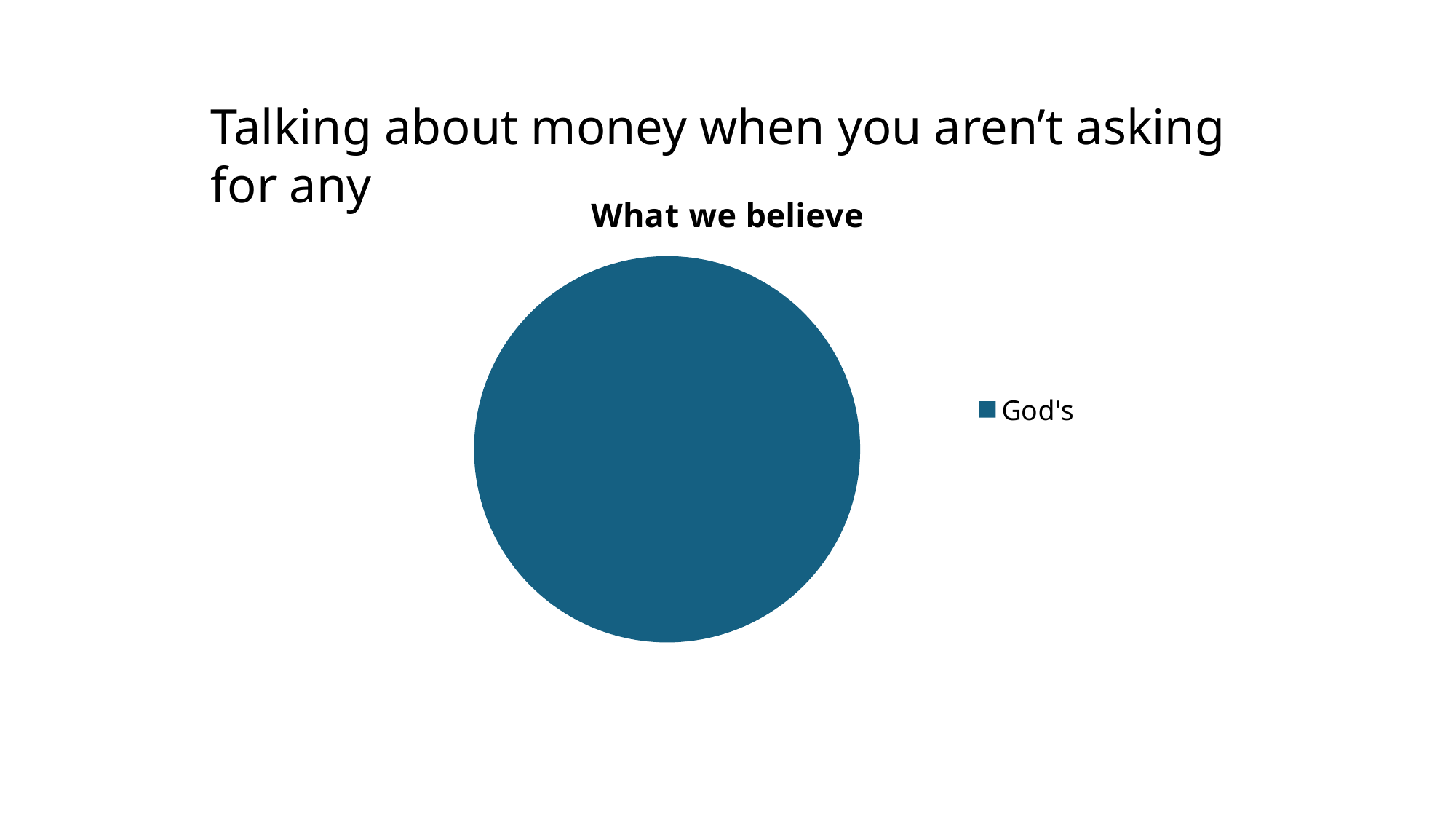
What is the title of the chart? What we believe What share of the pie does the "God's" slice take up? 100% How many slices does the pie chart have? 1 Which slice is the largest in the pie chart? God's What kind of chart is shown on the slide? pie chart What is the label of the only slice in the pie chart? God's How many entries does the chart's legend list? 1